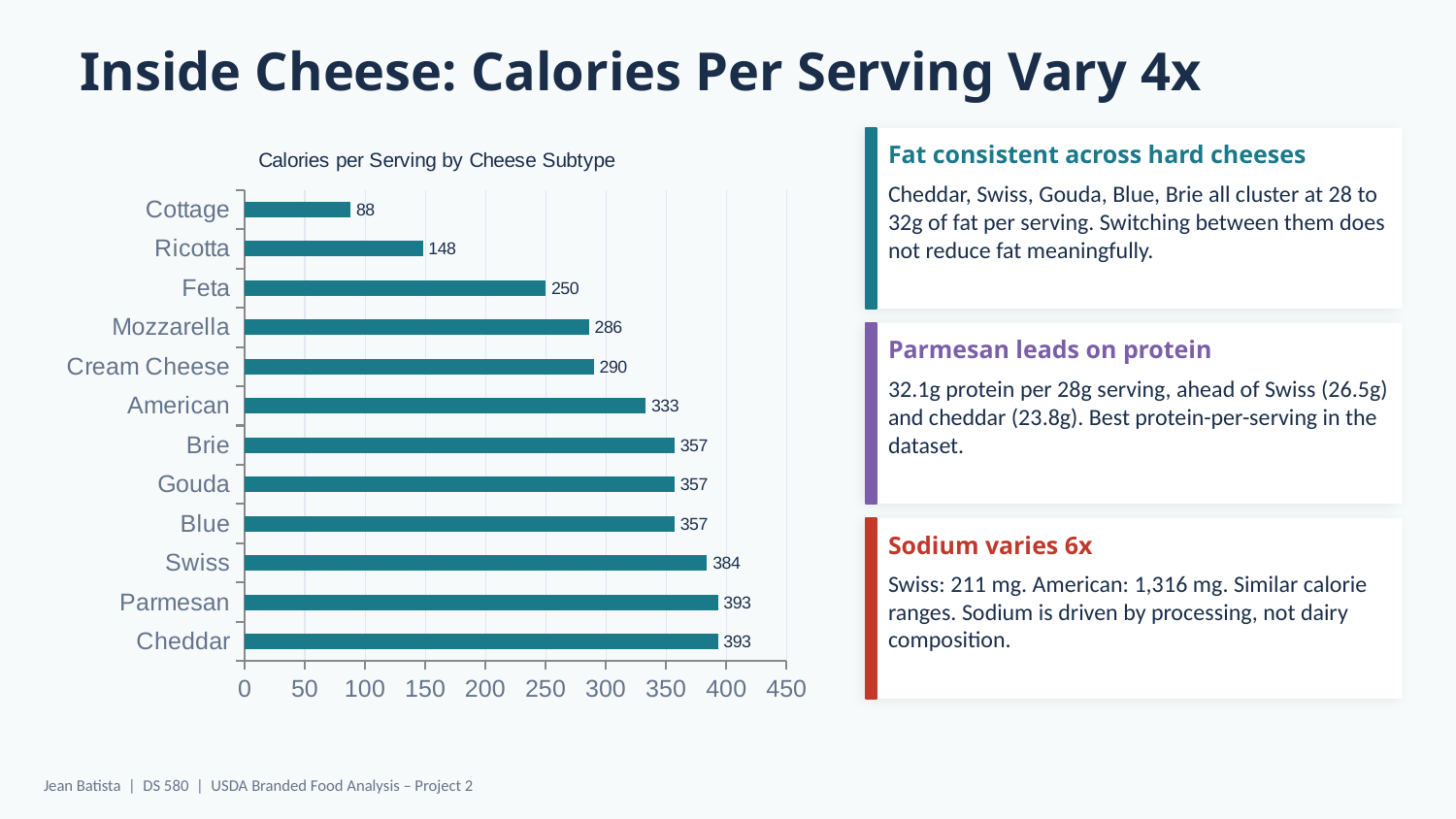
How many cheese subtypes are shown in the chart? 12 Which cheese subtype has the lowest calories per serving? Cottage What is the calories per serving value for Swiss? 384 What is the calories per serving value for Mozzarella? 286 What is the title of the chart on the slide? Calories per Serving by Cheese Subtype What is the calories per serving value for American cheese? 333 What is the difference in calories per serving between Feta and Ricotta? 102 Which has more calories per serving, Swiss or Brie? Swiss What is the calories per serving value for Cottage cheese? 88 What type of chart is used to show calories per serving by cheese subtype? Bar chart What is the difference in calories per serving between Cheddar and Cottage? 305 Is the value for Cream Cheese greater or less than 300? less